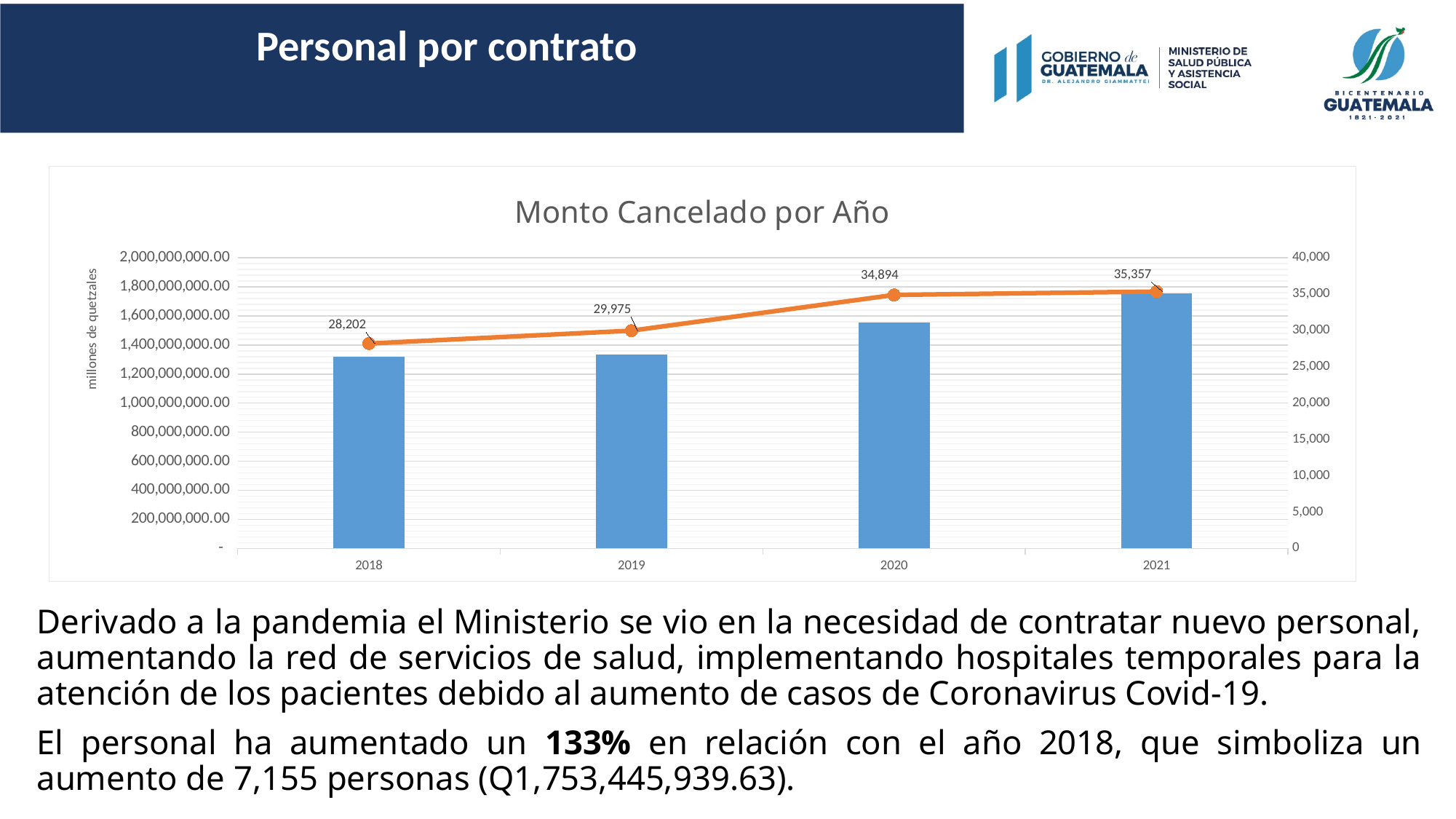
What is the data label on the line for 2020? 34,894 Is the bar value for 2018 greater or less than 1,400,000,000.00? less Do the line values rise or fall from 2018 to 2021? rise How many years are shown on the x axis? 4 What is the difference between the line values for 2021 and 2018? 7,155 What is the title of the chart? Monto Cancelado por Año Which year has the lowest value on the line series? 2018 Which year has the highest value on the line series? 2021 Is the bar value for 2021 greater or less than 1,600,000,000.00? greater What is the data label on the line for 2021? 35,357 What is the data label on the line for 2018? 28,202 Which year has a larger line value, 2019 or 2020? 2020